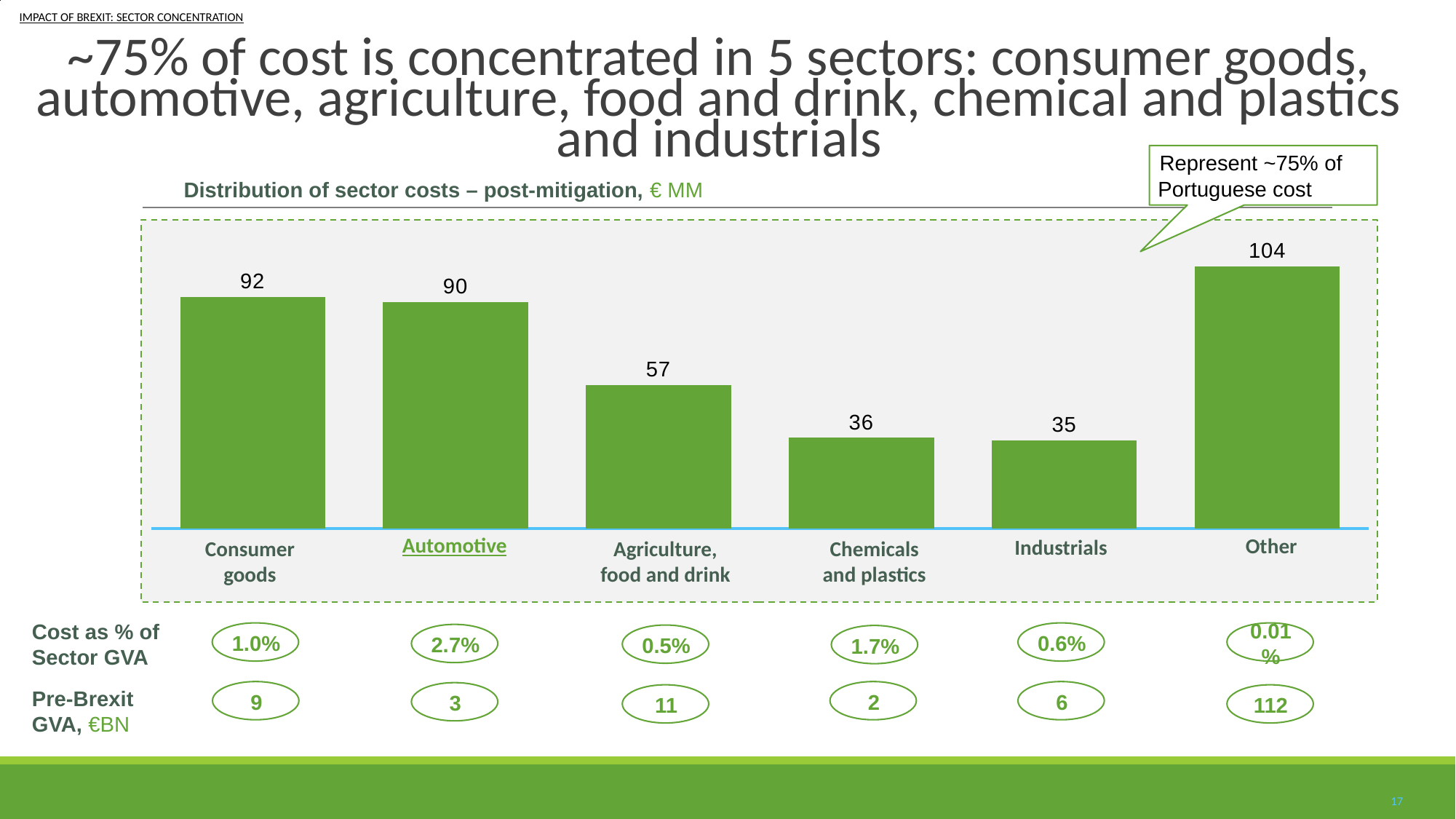
What kind of chart is shown on the slide? Bar chart Which category has the highest value? Other How many categories are shown in the chart? 6 What is the value for Agriculture, food and drink? 57 Which is larger, the value for Chemicals and plastics or the value for Agriculture, food and drink? Agriculture, food and drink What is the difference between the values for Automotive and Agriculture, food and drink? 33 Which category has the lowest value? Industrials What colour are the bars in the chart? Green What is the title of the chart? Distribution of sector costs – post-mitigation, € MM What is the value for Industrials? 35 What is the difference between the values for Other and Consumer goods? 12 What is the value for Consumer goods? 92